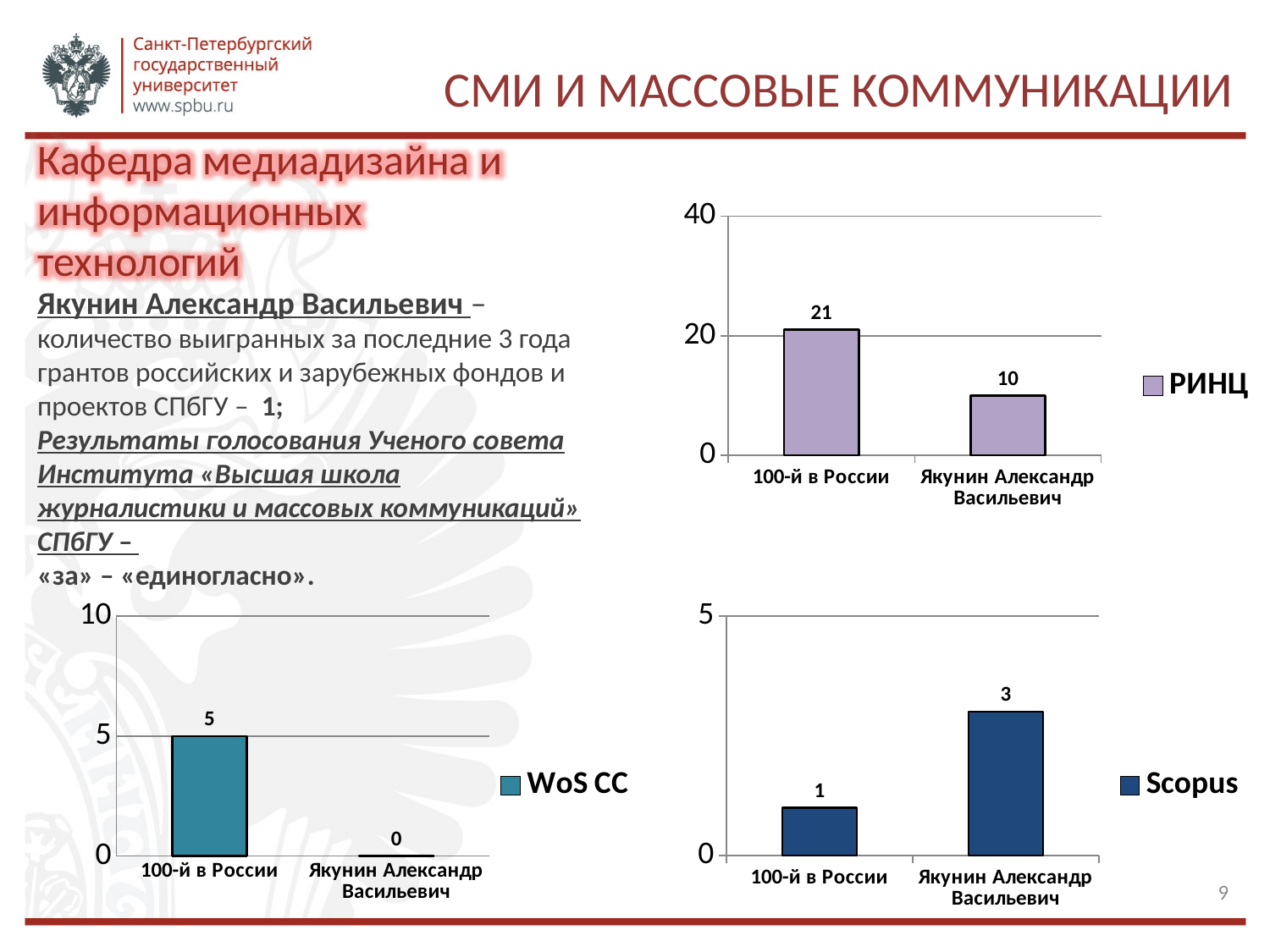
In the WoS CC chart, what is the value for 100-й в России? 5 In the Scopus chart, is the value for Якунин Александр Васильевич larger or smaller than the value for 100-й в России? larger In the РИНЦ chart, what is the value for 100-й в России? 21 In the WoS CC chart, which category has the highest value? 100-й в России How many categories are shown in the РИНЦ chart? 2 In the Scopus chart, which category has the lowest value? 100-й в России In the Scopus chart, what is the value for 100-й в России? 1 What kind of chart is the Scopus chart? bar chart In the РИНЦ chart, what is the difference between the values for 100-й в России and Якунин Александр Васильевич? 11 In the WoS CC chart, what is the value for Якунин Александр Васильевич? 0 In the РИНЦ chart, what is the value for Якунин Александр Васильевич? 10 In the Scopus chart, what is the value for Якунин Александр Васильевич? 3